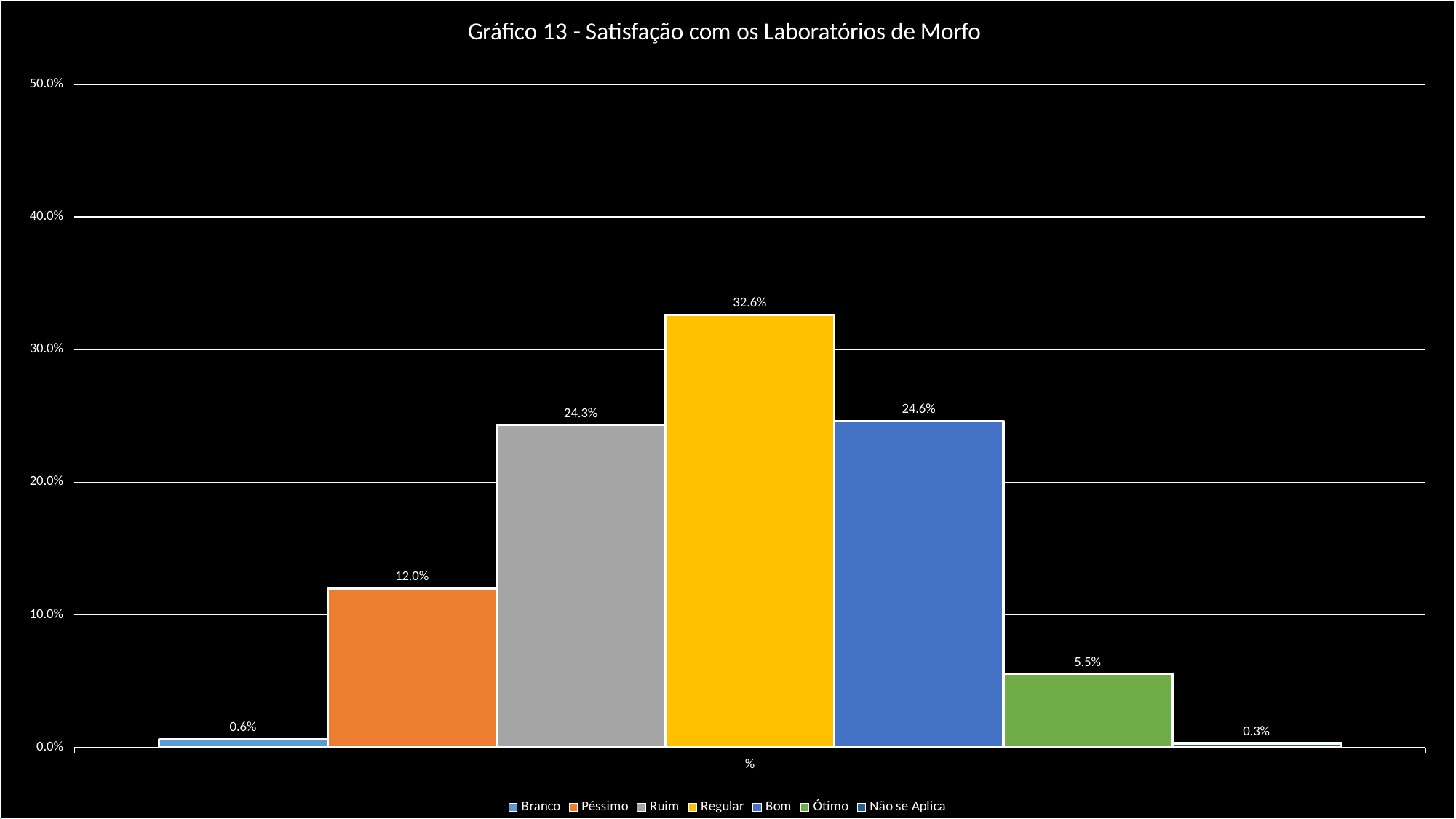
What kind of chart is shown? bar chart What is the title of the chart? Gráfico 13 - Satisfação com os Laboratórios de Morfo Is the value for Ruim greater or less than 20.0%? greater What is the value for Péssimo? 12.0% Which is larger, the value for Péssimo or the value for Ótimo? Péssimo Which series has the lowest value? Não se Aplica What is the value for Ótimo? 5.5% How many series does the legend list? 7 Which series has the highest value? Regular What is the value for Regular? 32.6% What is the difference between the values for Regular and Bom? 8.0% What is the value for Não se Aplica? 0.3%